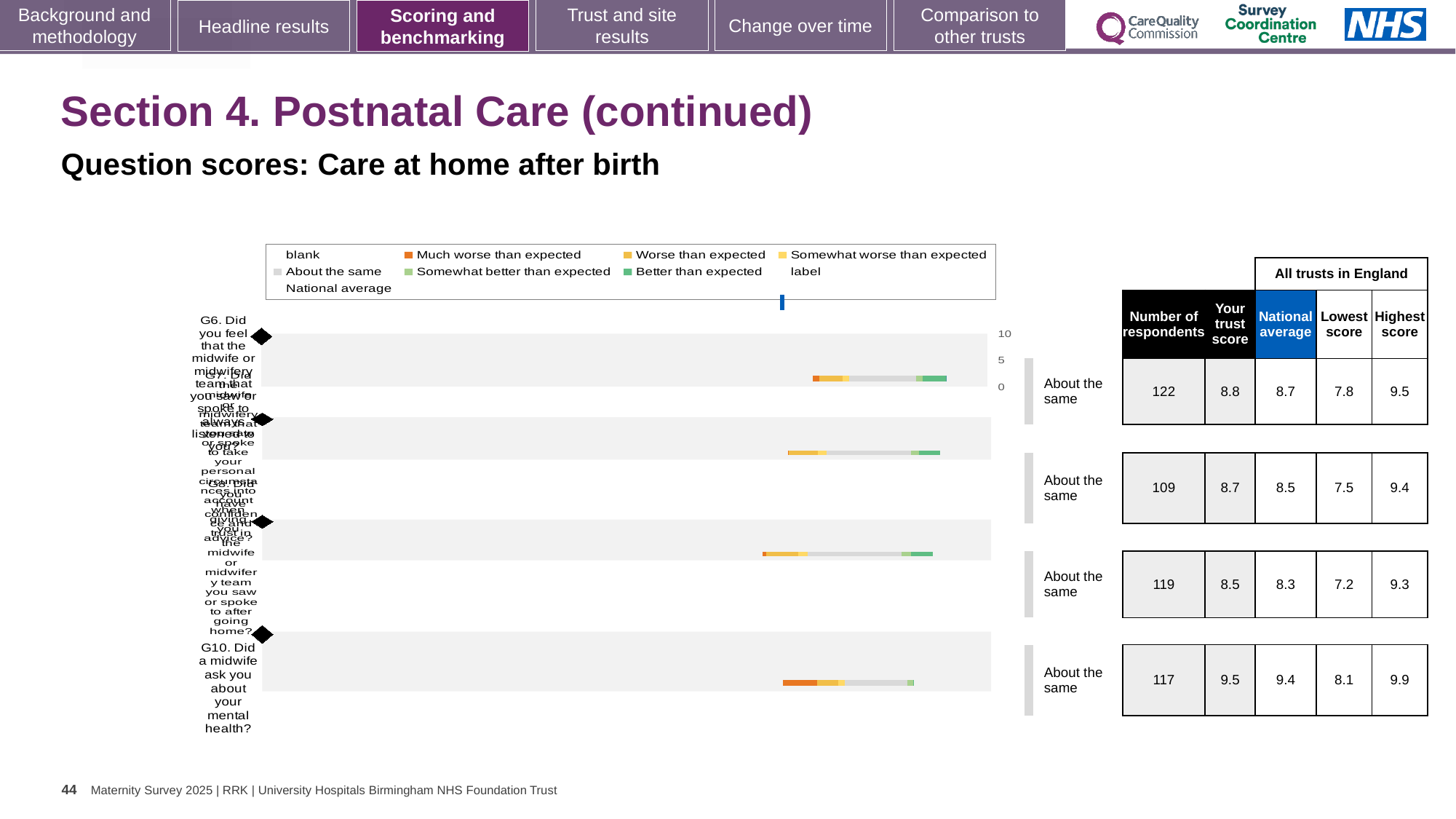
What kind of chart is used to show the question scores for care at home after birth? bar chart Which question has the highest trust score? G10 What is the highest score among all trusts in England for G10? 9.9 What is the difference between the trust score and the national average for G10? 0.1 What is the lowest trust score shown in the table? 8.5 What is the lowest score among all trusts in England for the first question (G6)? 7.8 What is the trust score for G10 (Did a midwife ask you about your mental health?)? 9.5 For G6, which is larger: the trust score or the national average? the trust score How many respondents answered G6 (the first question in the chart)? 122 How is the trust's result categorised for each of the four questions? About the same How many questions (rows) are plotted in the chart? 4 What is the difference between the highest and lowest scores for G10? 1.8